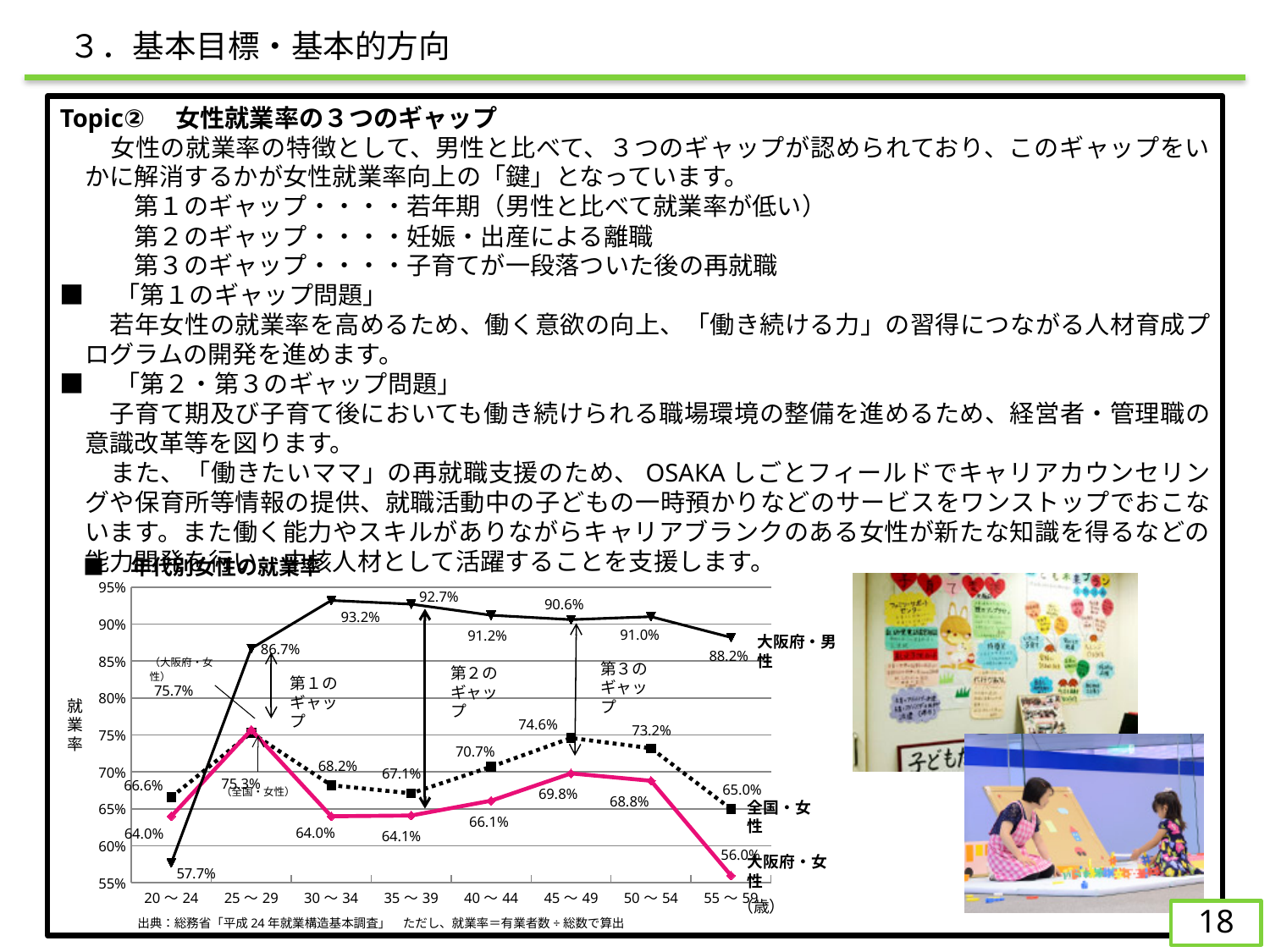
What is the value for 大阪府・女性 in the 55～59 age group? 56.0% How many series does the chart show? 3 What kind of chart is shown on the slide? line chart What is the difference between 大阪府・男性 and 大阪府・女性 in the 35～39 age group? 28.6 percentage points Does the value for 大阪府・女性 rise or fall from the 45～49 age group to the 55～59 age group? fall What is the value for 全国・女性 in the 45～49 age group? 74.6% What is the value for 大阪府・男性 in the 30～34 age group? 93.2% In which age group is the value for 大阪府・男性 highest? 30～34 What is the value for 大阪府・男性 in the 25～29 age group? 86.7% In the 40～44 age group, which is larger: 全国・女性 or 大阪府・女性? 全国・女性 In which age group is the value for 大阪府・女性 lowest? 55～59 How many age groups are plotted along the x axis? 8